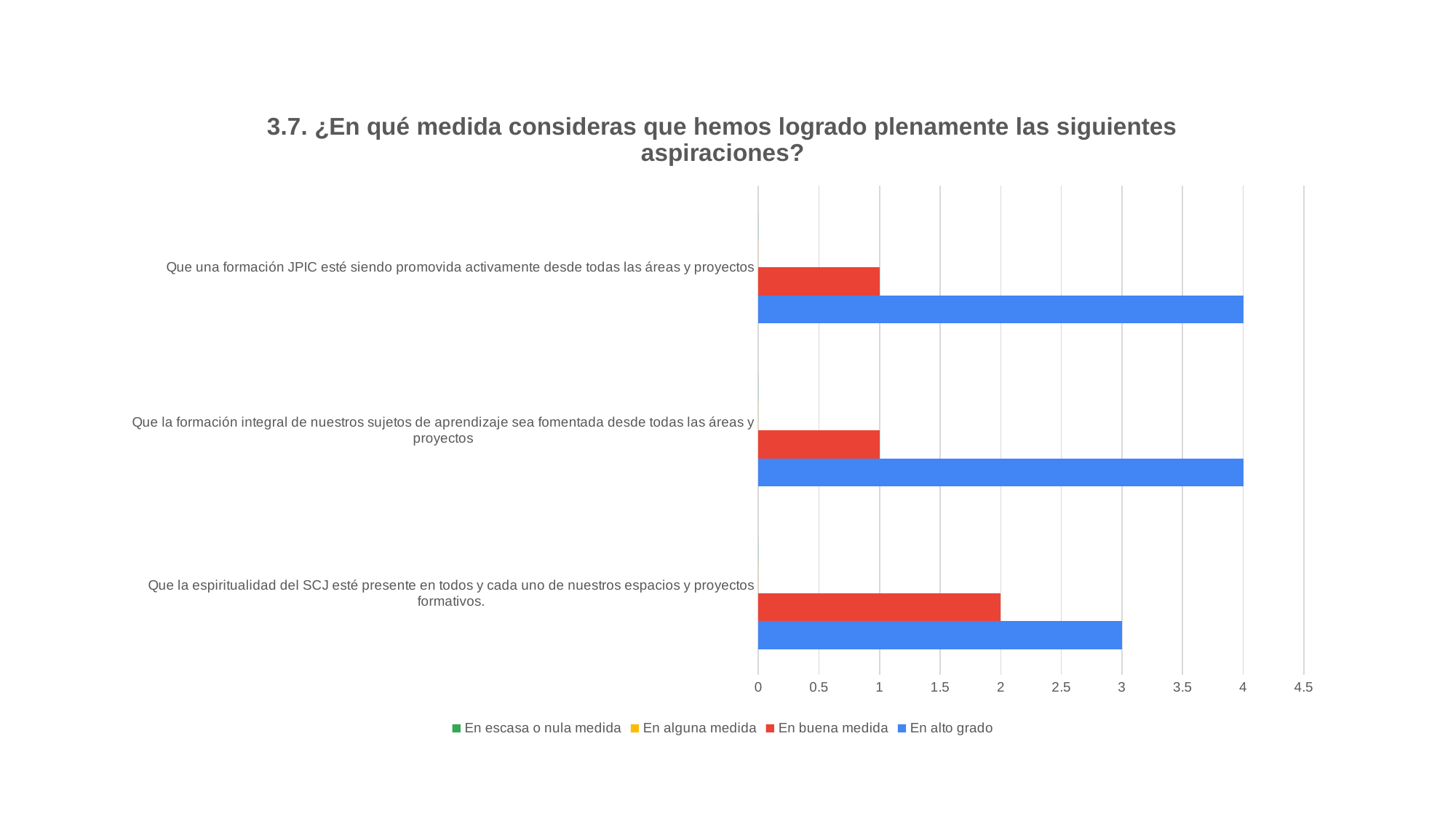
How many series does the legend list? 4 What is the difference between the "En alto grado" and "En buena medida" values for "Que una formación JPIC esté siendo promovida activamente desde todas las áreas y proyectos"? 3 Which category has the lowest value for "En alto grado"? Que la espiritualidad del SCJ esté presente en todos y cada uno de nuestros espacios y proyectos formativos. How many categories (aspirations) are plotted on the chart? 3 Which category has the highest value for "En buena medida"? Que la espiritualidad del SCJ esté presente en todos y cada uno de nuestros espacios y proyectos formativos. What kind of chart is shown on the slide? bar chart What is the value of "En alto grado" for "Que la espiritualidad del SCJ esté presente en todos y cada uno de nuestros espacios y proyectos formativos."? 3 What is the value of "En buena medida" for "Que la formación integral de nuestros sujetos de aprendizaje sea fomentada desde todas las áreas y proyectos"? 1 For "Que la espiritualidad del SCJ esté presente en todos y cada uno de nuestros espacios y proyectos formativos.", which is larger: "En buena medida" or "En alto grado"? En alto grado What is the value of "En buena medida" for "Que la espiritualidad del SCJ esté presente en todos y cada uno de nuestros espacios y proyectos formativos."? 2 What is the value of "En alto grado" for "Que una formación JPIC esté siendo promovida activamente desde todas las áreas y proyectos"? 4 Which colour represents the "En alto grado" series in the legend? blue